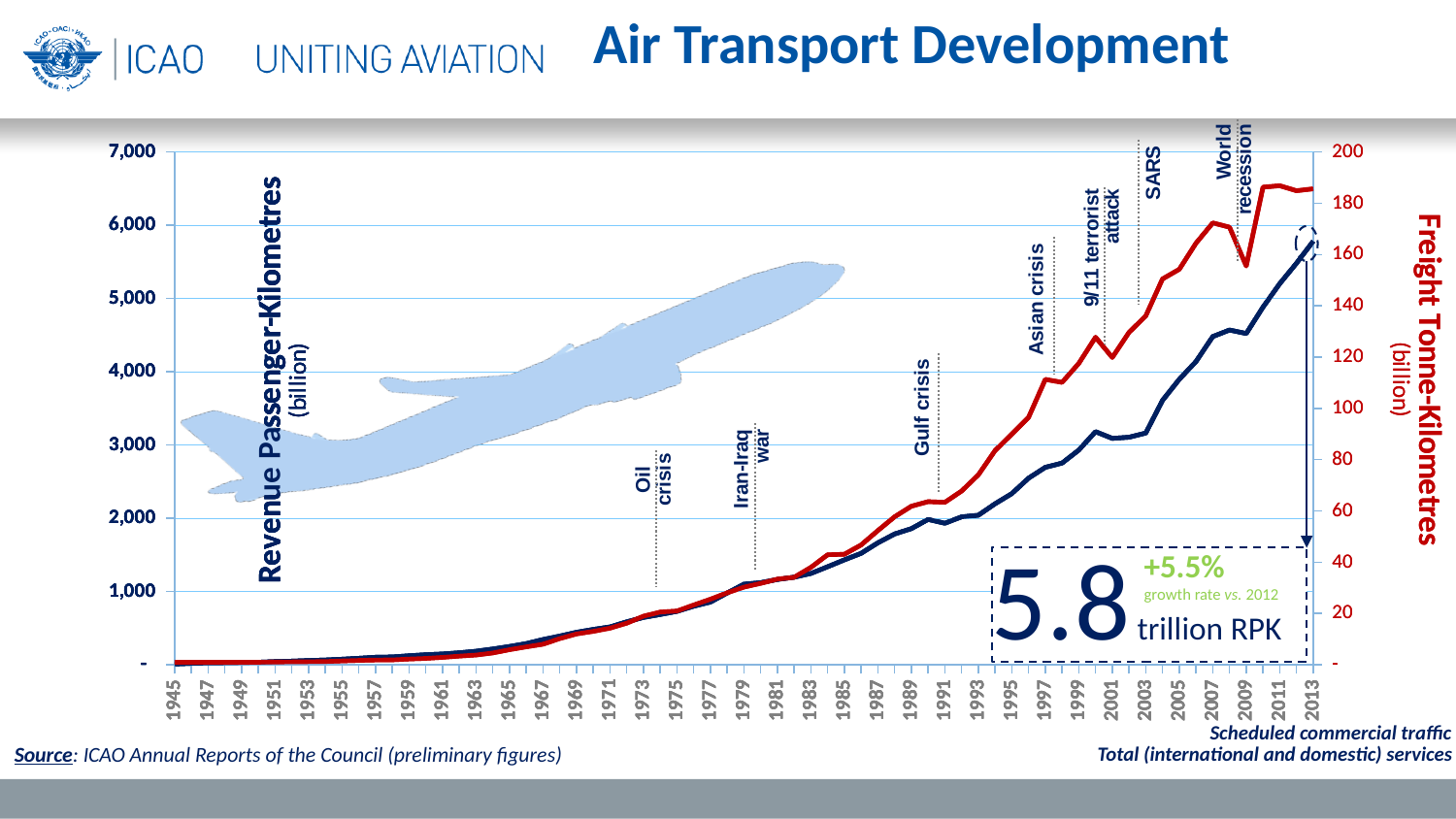
Is the Revenue Passenger-Kilometres value for 2007 greater or less than 4,000? greater Is the Freight Tonne-Kilometres value for 1997 greater or less than 100? greater What value of RPK is highlighted for 2013 in the callout box? 5.8 trillion RPK What is the first year shown on the x axis? 1945 Do Freight Tonne-Kilometres generally rise or fall from 1945 to 2013? rise How many historical events are annotated on the chart? 7 Is the Revenue Passenger-Kilometres value for 1985 greater or less than 2,000? less Do Revenue Passenger-Kilometres generally rise or fall from 1945 to 2013? rise What kind of chart is shown on the slide? line chart Which series is plotted in red? Freight Tonne-Kilometres What growth rate vs. 2012 is shown in the callout box? +5.5%